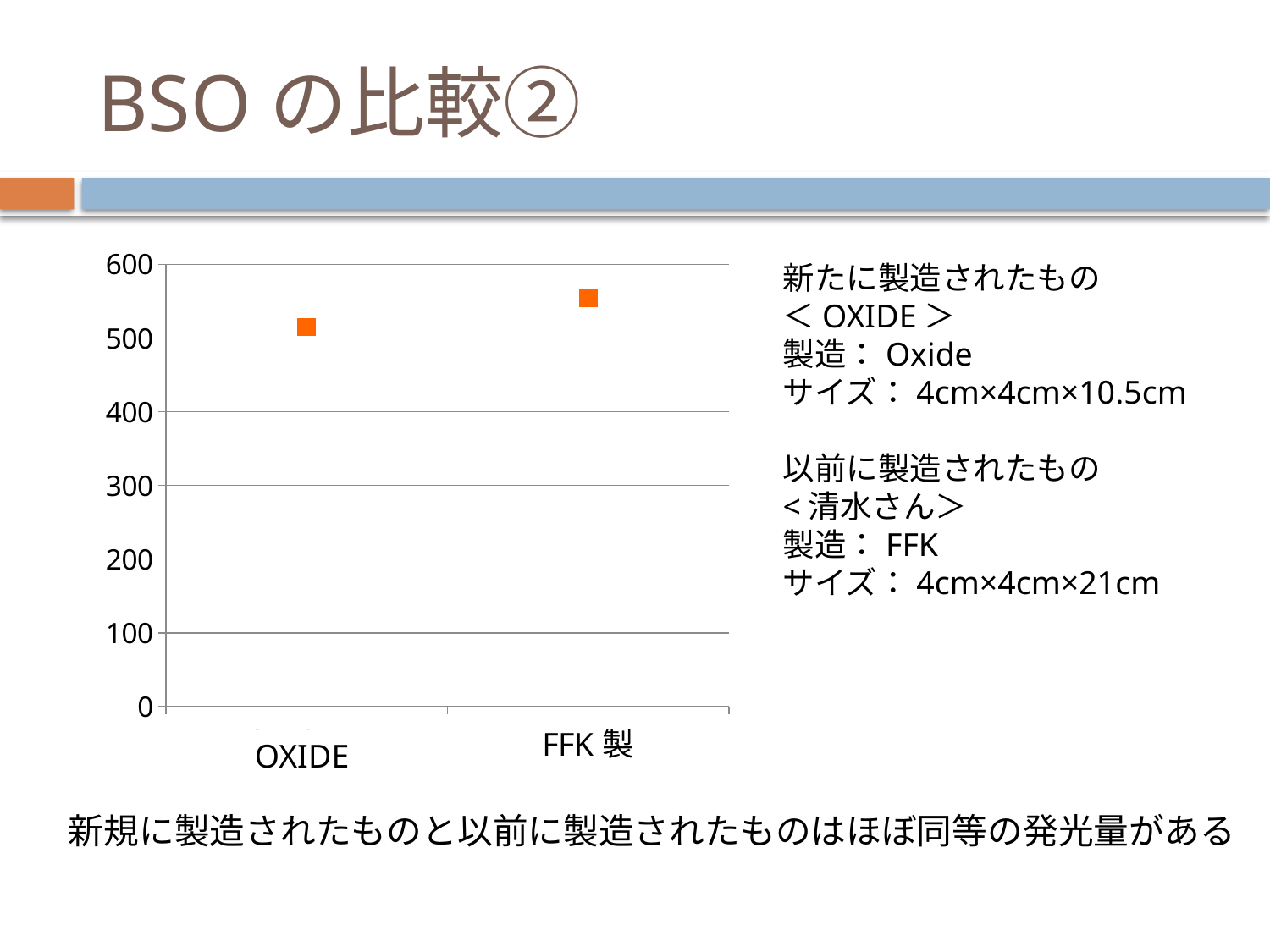
What is the maximum value shown on the vertical axis? 600 What kind of chart is shown on the slide? scatter chart Is the value for OXIDE greater or less than 500? greater Is the value for FFK製 greater or less than 600? less What colour are the plotted markers in the chart? orange How many data points are plotted in the chart? 2 Do the plotted values rise or fall from OXIDE to FFK製 along the x axis? rise Is the value for FFK製 greater or less than 500? greater Which category has the highest plotted value? FFK製 Which category has the lowest plotted value? OXIDE Which is larger, the value for OXIDE or the value for FFK製? FFK製